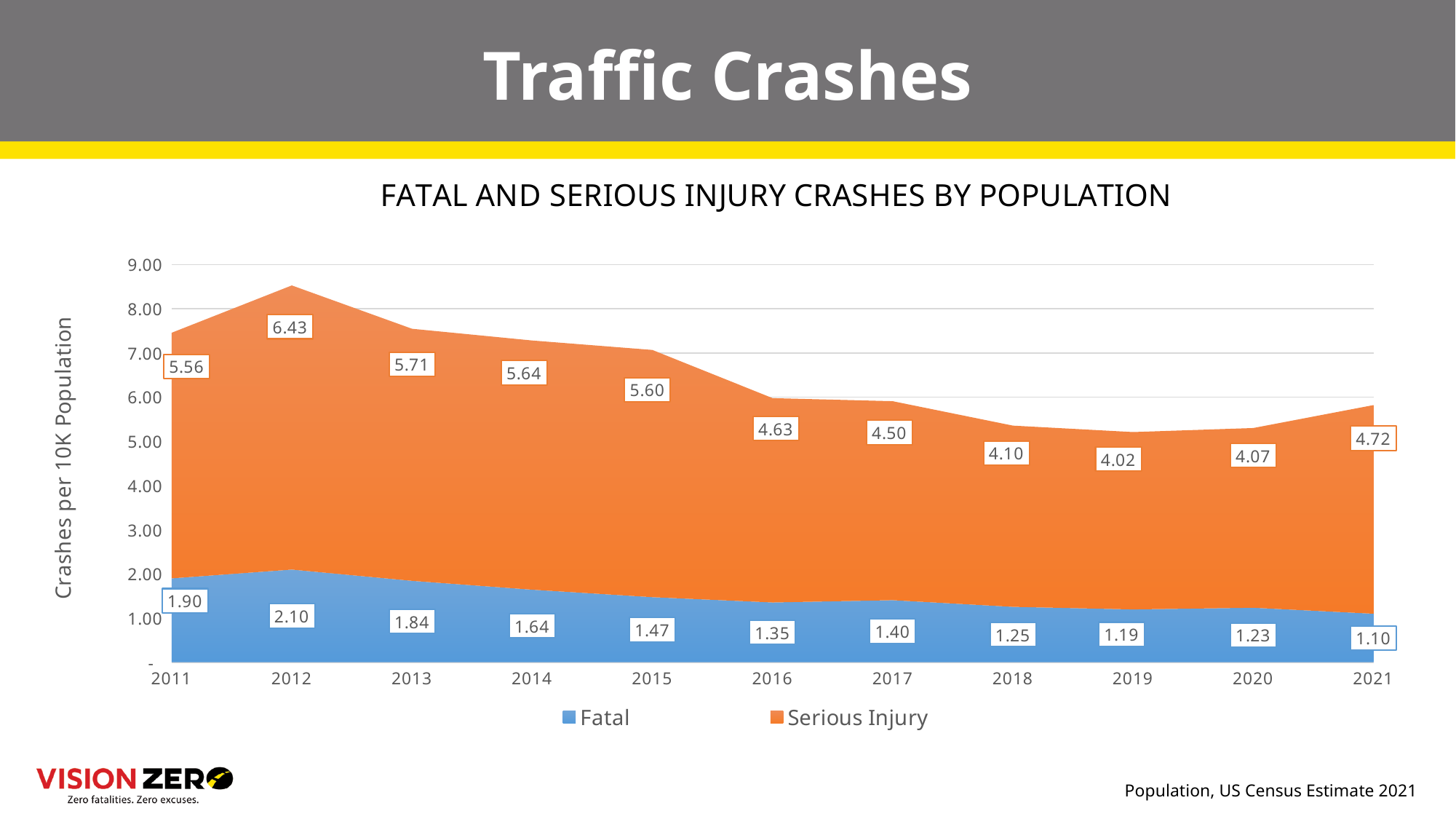
What is the label of the y axis? Crashes per 10K Population Is the Fatal crash rate higher in 2011 or in 2021? 2011 What is the combined Fatal and Serious Injury crash rate for 2021? 5.82 How many series does the legend list? 2 Is the Serious Injury crash rate for 2016 greater or less than 4.00? greater Which year has the lowest Fatal crash rate? 2021 What kind of chart is shown on the slide? Stacked area chart How many years are shown on the x axis? 11 What is the Serious Injury crash rate for 2019? 4.02 What is the Fatal crash rate for 2012? 2.10 What is the difference between the Serious Injury rate in 2012 and in 2019? 2.41 Which year has the highest Serious Injury crash rate? 2012